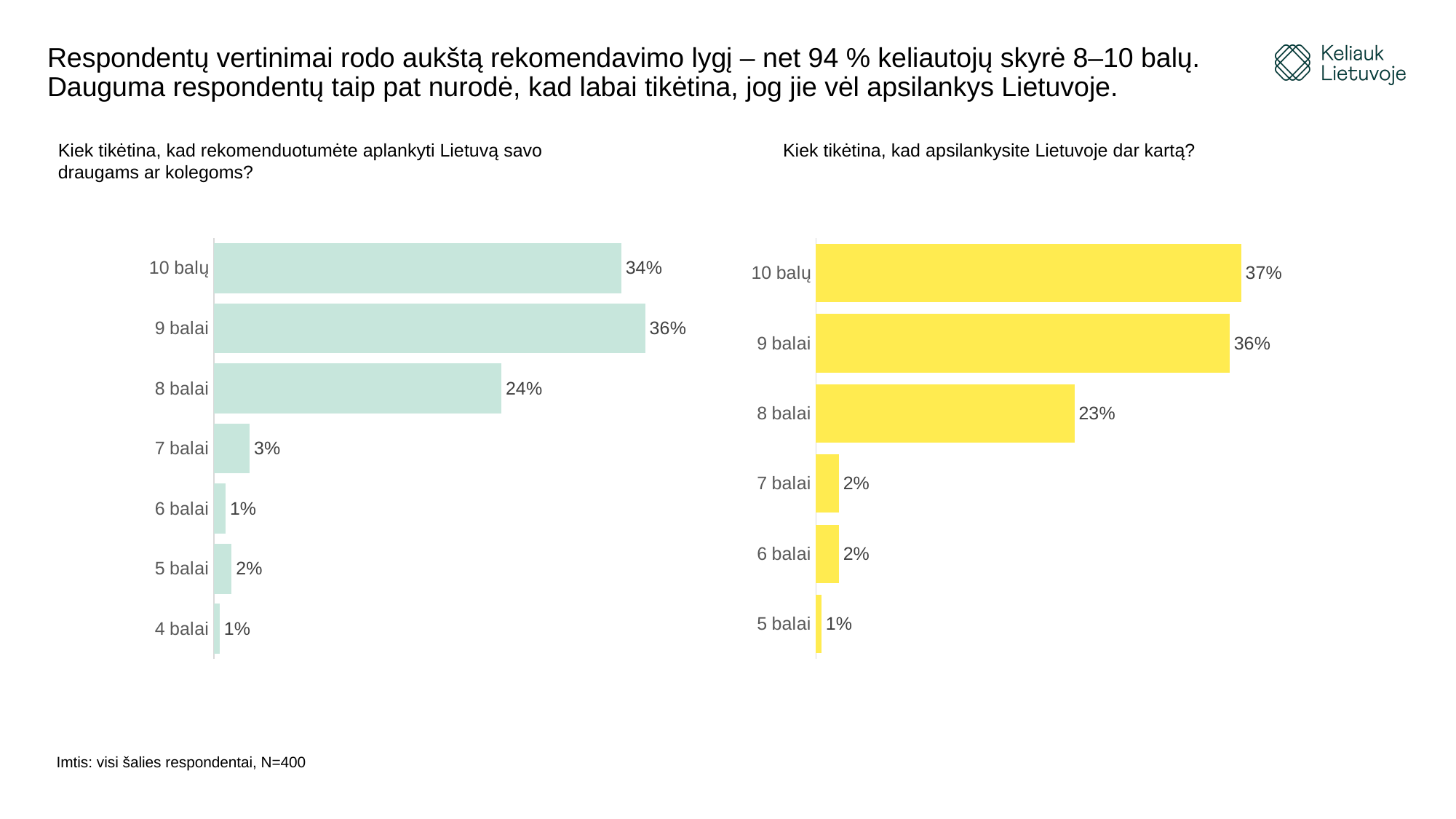
In the right chart (Kiek tikėtina, kad apsilankysite Lietuvoje dar kartą?), which is larger, the value for 9 balai or 8 balai? 9 balai In the right chart (Kiek tikėtina, kad apsilankysite Lietuvoje dar kartą?), what is the difference between the values for 10 balų and 8 balai? 14% In the left chart (Kiek tikėtina, kad rekomenduotumėte aplankyti Lietuvą savo draugams ar kolegoms?), what is the value for 7 balai? 3% In the left chart (Kiek tikėtina, kad rekomenduotumėte aplankyti Lietuvą savo draugams ar kolegoms?), how many categories are shown? 7 In the left chart (Kiek tikėtina, kad rekomenduotumėte aplankyti Lietuvą savo draugams ar kolegoms?), what is the value for 10 balų? 34% In the left chart (Kiek tikėtina, kad rekomenduotumėte aplankyti Lietuvą savo draugams ar kolegoms?), which category has the highest value? 9 balai In the right chart (Kiek tikėtina, kad apsilankysite Lietuvoje dar kartą?), which category has the lowest value? 5 balai In the right chart (Kiek tikėtina, kad apsilankysite Lietuvoje dar kartą?), what is the value for 10 balų? 37% In the left chart (Kiek tikėtina, kad rekomenduotumėte aplankyti Lietuvą savo draugams ar kolegoms?), what is the difference between the values for 9 balai and 8 balai? 12% In the right chart (Kiek tikėtina, kad apsilankysite Lietuvoje dar kartą?), how many categories are shown? 6 What colour are the bars in the right chart (Kiek tikėtina, kad apsilankysite Lietuvoje dar kartą?)? Yellow What kind of chart is the left chart (Kiek tikėtina, kad rekomenduotumėte aplankyti Lietuvą savo draugams ar kolegoms?)? Bar chart